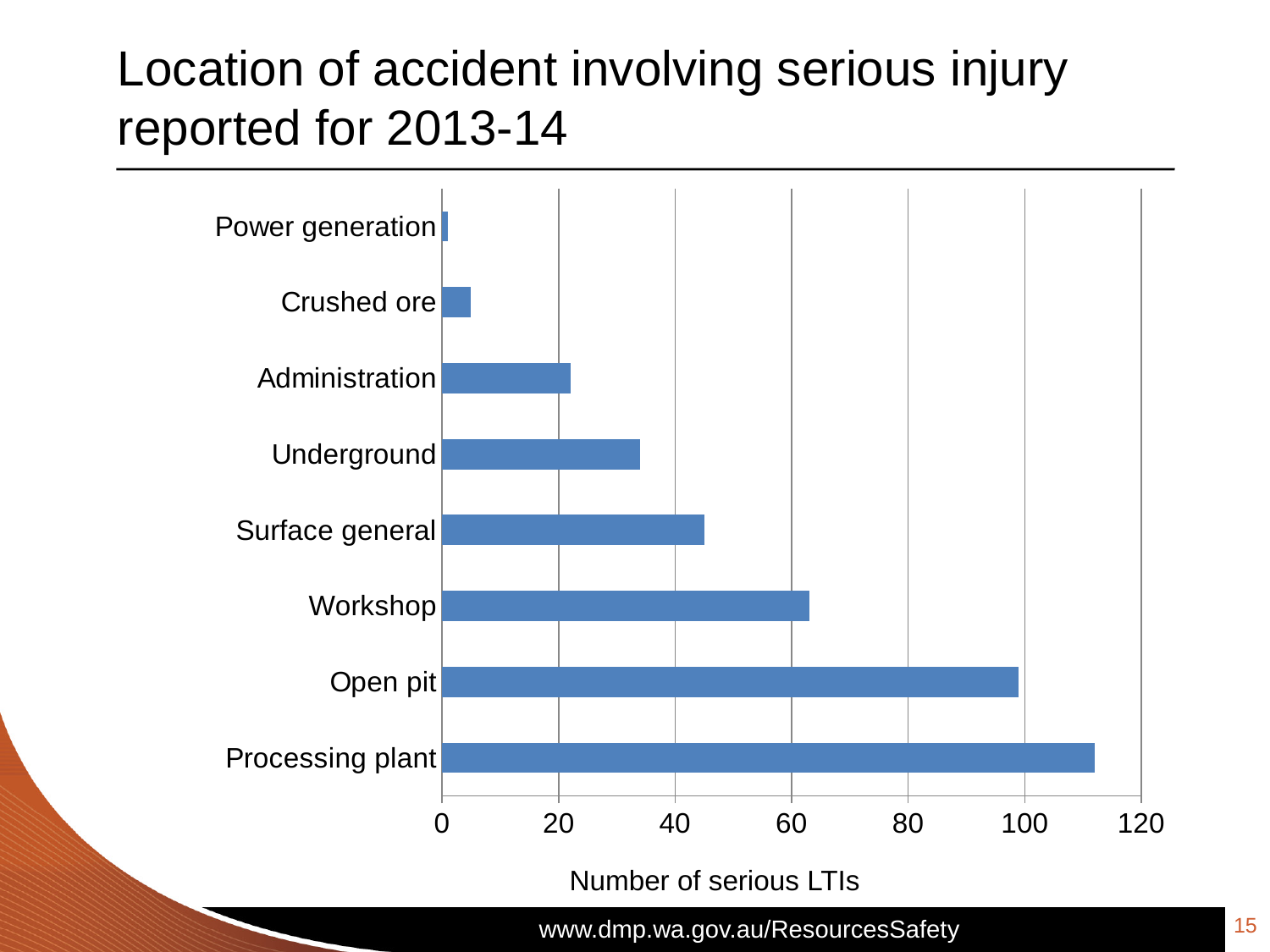
Is the value for Underground greater or less than 40? less Which location has the highest number of serious LTIs? Processing plant Which location has the lowest number of serious LTIs? Power generation Is the value for Crushed ore greater or less than 20? less How many locations are shown on the chart? 8 Which has more serious LTIs, Workshop or Underground? Workshop Is the value for Open pit greater or less than 80? greater What is the label of the horizontal axis? Number of serious LTIs What kind of chart is shown on the slide? bar chart